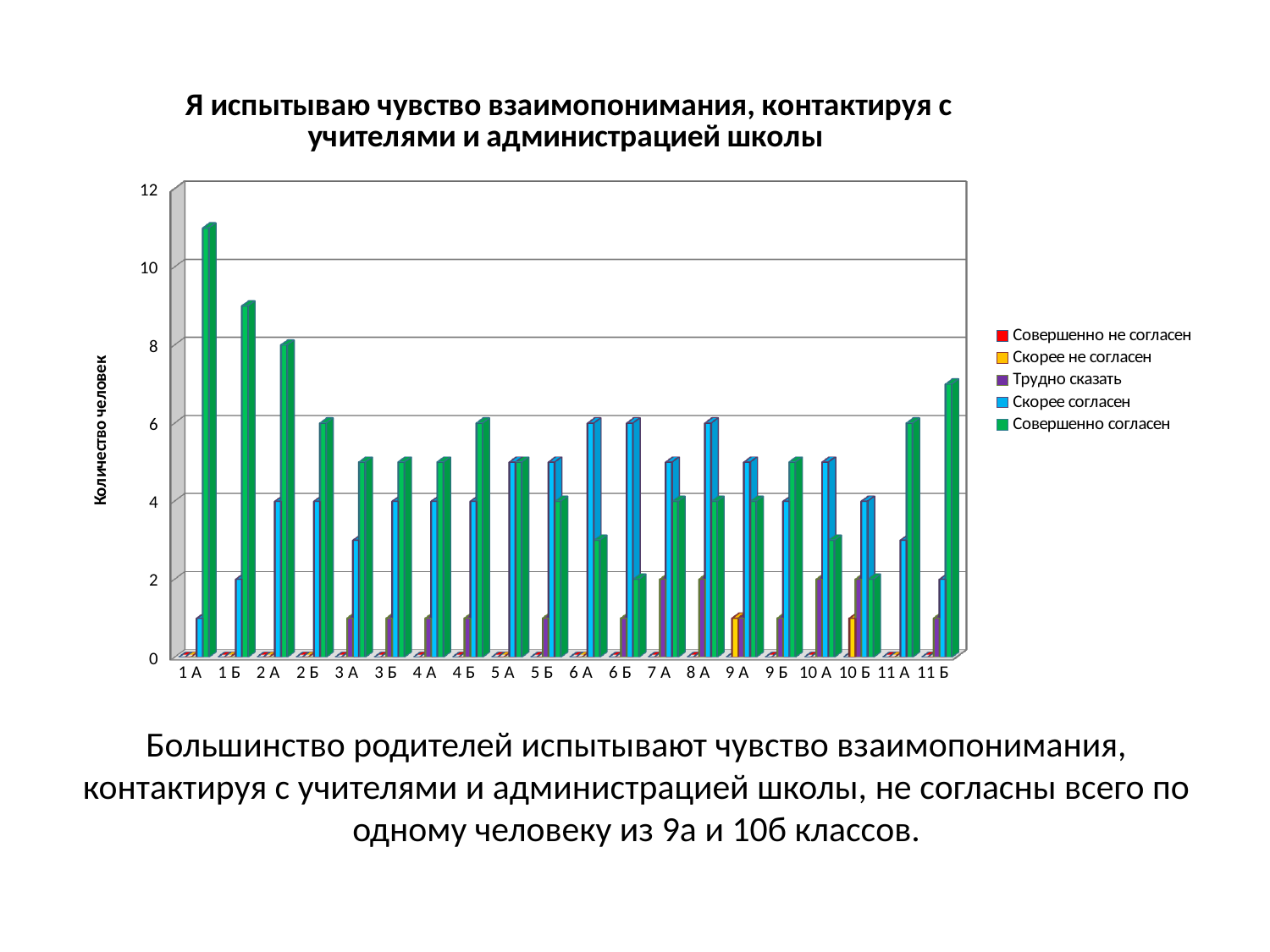
What kind of chart is shown on the slide? bar chart Which class has the highest value for 'Совершенно согласен'? 1 А Is the value for 'Совершенно согласен' in class 1 Б greater or less than 8? greater What colour represents the series 'Совершенно согласен' in the legend? green Which is larger in class 6 А: 'Скорее согласен' or 'Совершенно согласен'? Скорее согласен Is the value for 'Скорее не согласен' in class 9 А greater or less than 2? less What is the label of the vertical axis? Количество человек Which class has the larger value for 'Совершенно согласен': 1 А or 2 А? 1 А How many series does the legend list? 5 How many classes (categories) are shown along the x axis? 20 Is the value for 'Скорее согласен' in class 3 А greater or less than 4? less